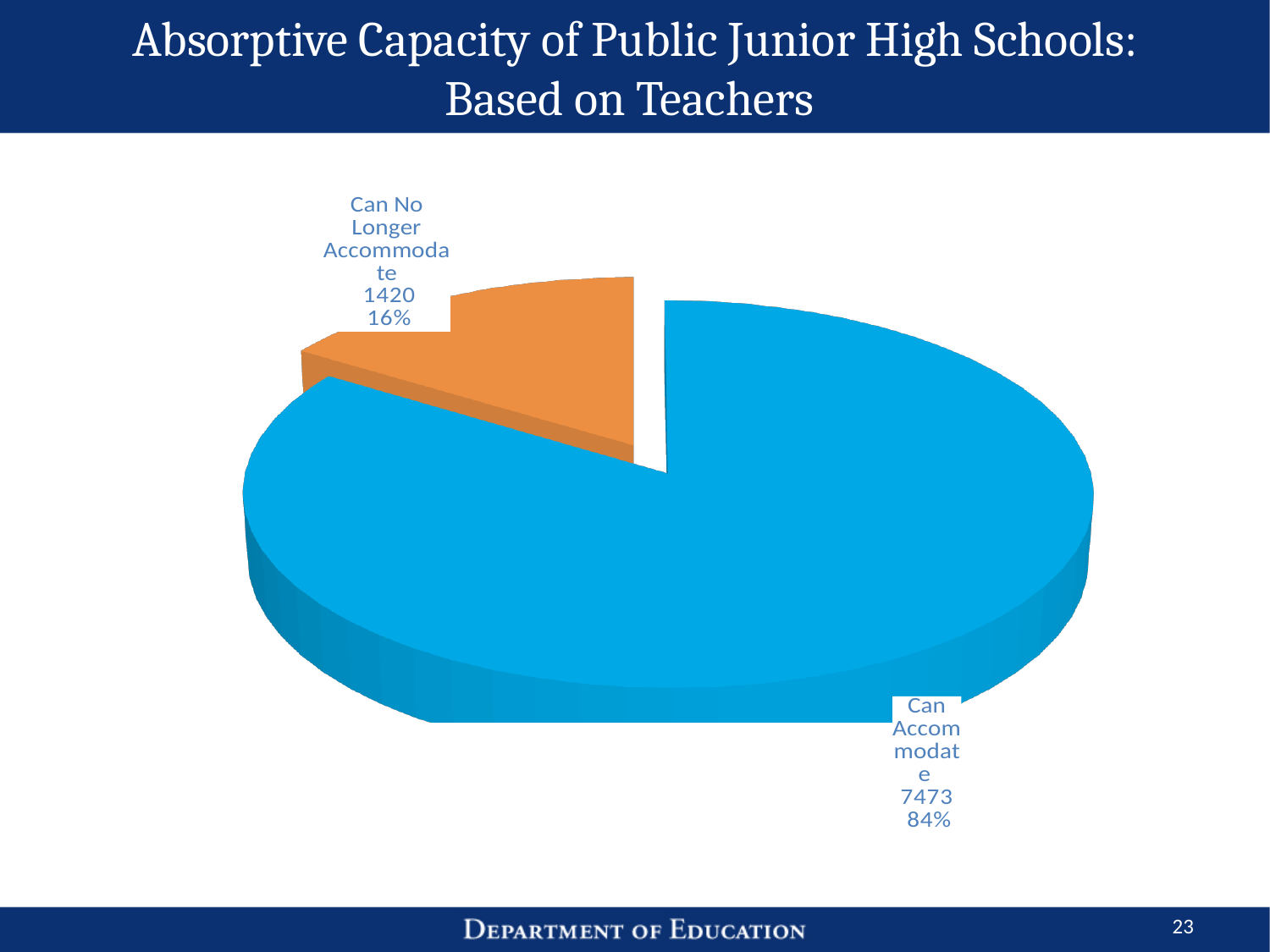
How many slices does the pie chart have? 2 What is the value for "Can Accommodate"? 7473 What is the value for "Can No Longer Accommodate"? 1420 What is the total of the two slices in the pie chart? 8893 What is the difference between the values for "Can Accommodate" and "Can No Longer Accommodate"? 6053 Which category has the largest slice? Can Accommodate Which category has the smallest slice? Can No Longer Accommodate Which is larger, "Can Accommodate" or "Can No Longer Accommodate"? Can Accommodate What share of the pie does "Can No Longer Accommodate" represent? 16% What share of the pie does "Can Accommodate" represent? 84% What colour is the "Can No Longer Accommodate" slice? Orange What kind of chart is shown on the slide? Pie chart